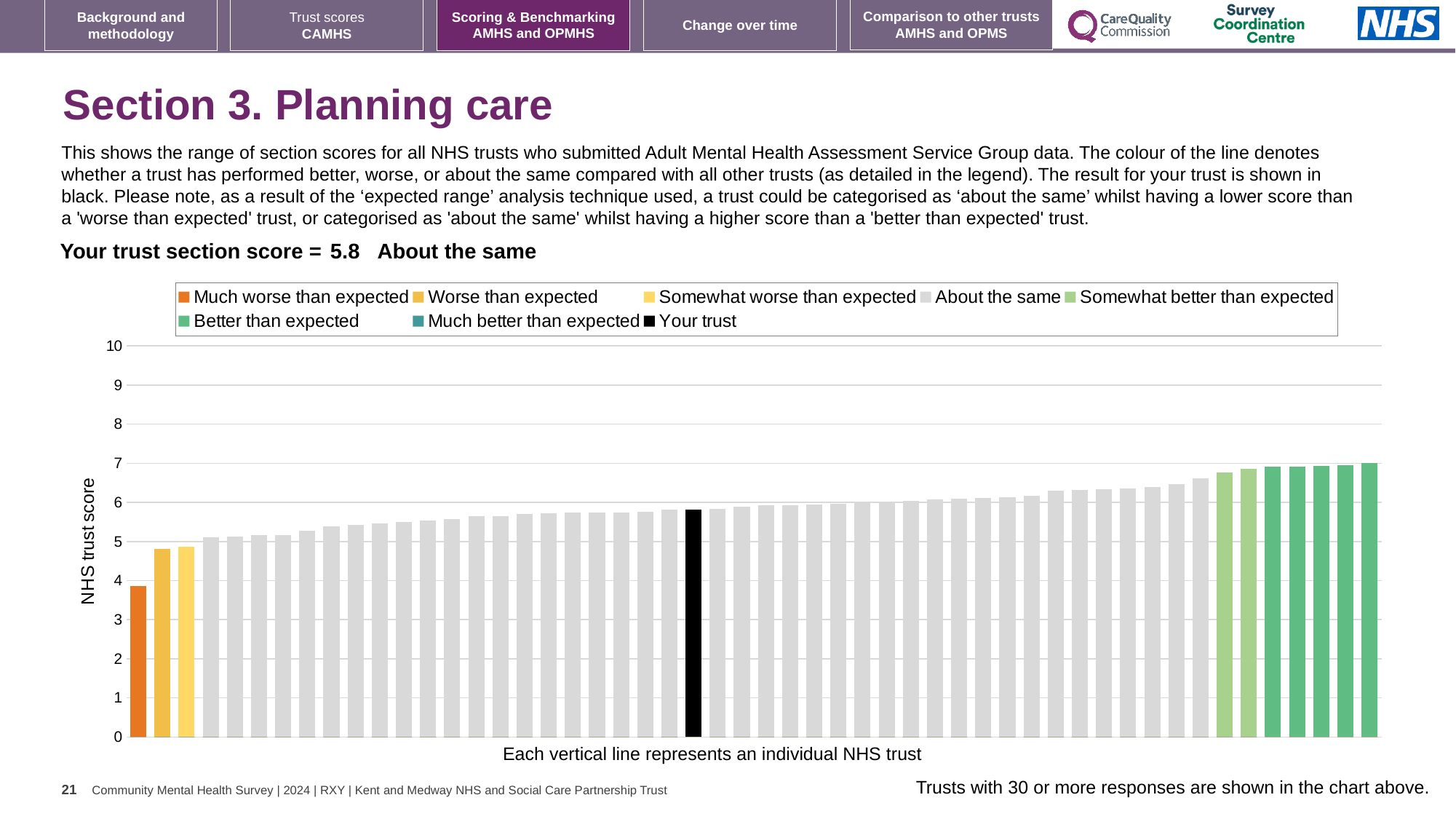
Is the value of the tallest bar on the right greater or less than 6? greater Which category is your trust placed in for this section? About the same Is the value of the lowest bar (the orange one) greater or less than 5? less How many entries does the chart legend list? 8 How many orange 'Much worse than expected' bars are in the chart? 1 What kind of chart is shown on the slide? Bar chart Is the value of the black 'Your trust' bar greater or less than 6? less Is the black 'Your trust' bar higher or lower than the orange 'Much worse than expected' bar? higher Do the bar values rise or fall moving from left to right along the x axis? rise What is the section score for your trust shown on the slide? 5.8 What is the label on the vertical axis of the chart? NHS trust score